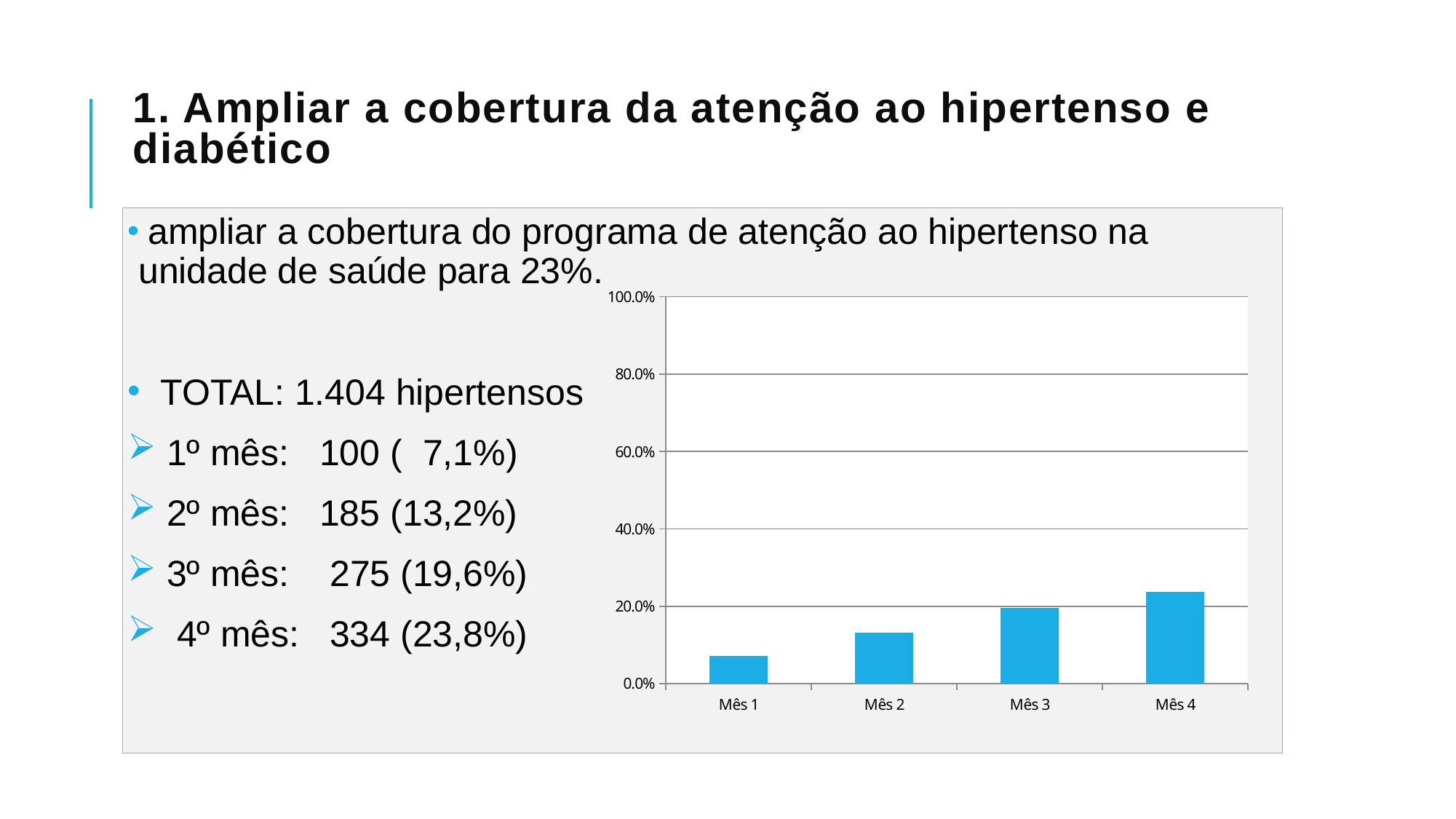
Which month has the lowest bar in the chart? Mês 1 Which month has the highest bar in the chart? Mês 4 Is the value for Mês 4 greater or less than 40.0%? less How many categories (months) are plotted on the x axis of the chart? 4 Which is larger, the bar for Mês 2 or the bar for Mês 3? Mês 3 Is the value for Mês 1 greater or less than 20.0%? less What is the highest value shown on the chart's vertical axis? 100.0% What colour are the bars in the chart? blue What kind of chart is shown on the slide? bar chart Do the bar values rise or fall from Mês 1 to Mês 4? rise Is the value for Mês 2 greater or less than 20.0%? less